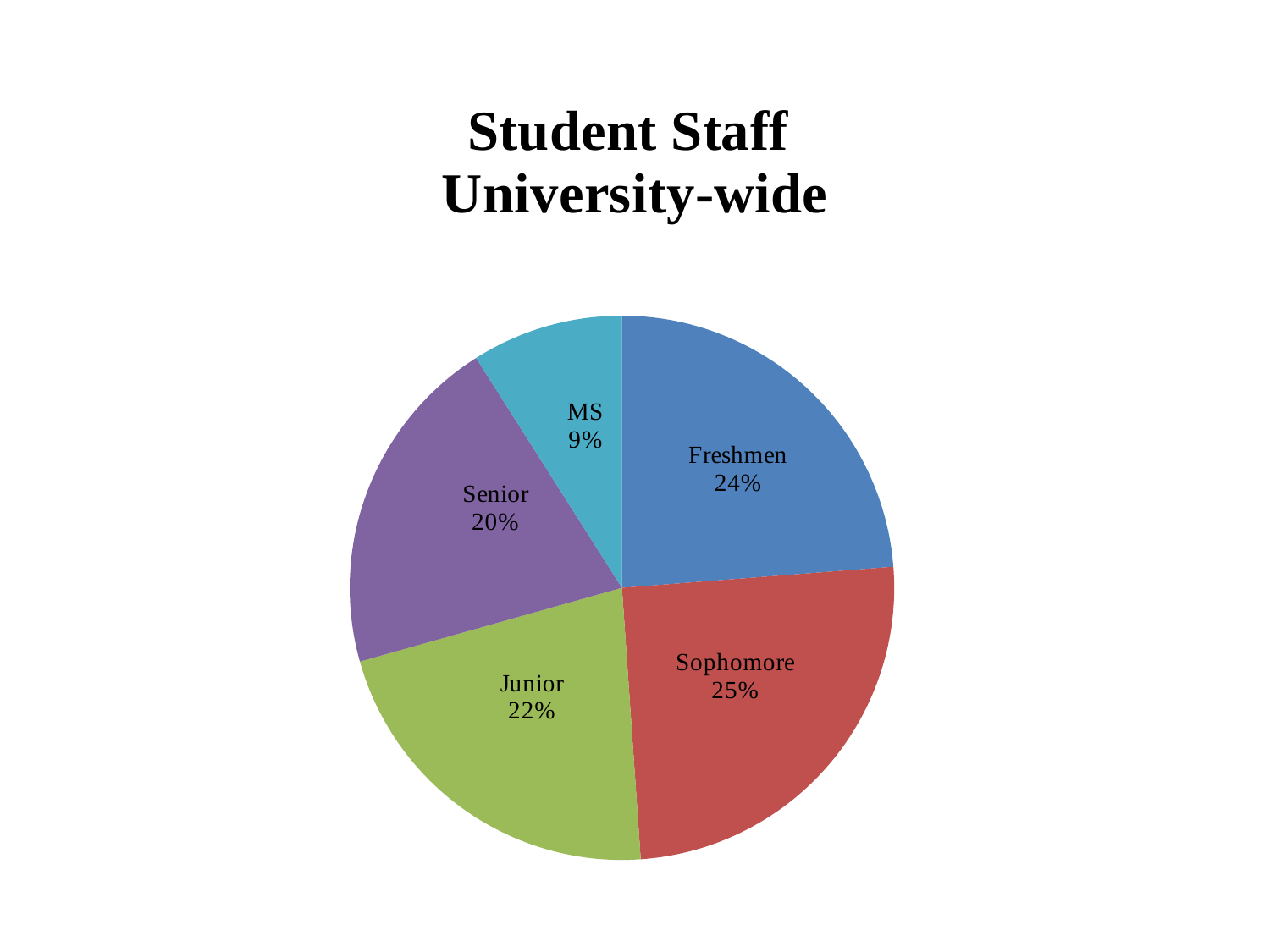
Which category has the smallest slice of the pie? MS Which category has the largest slice of the pie? Sophomore What share of the pie does the Sophomore slice represent? 25% What is the value shown for Freshmen? 24% What is the value shown for Senior? 20% What percentage is shown for the MS slice? 9% What is the difference in percentage points between the Freshmen and MS slices? 15 What is the difference in percentage points between the Junior and Senior slices? 2 Which is larger, the Junior slice or the Senior slice? Junior What kind of chart is shown on the slide? Pie chart What is the title of the chart? Student Staff University-wide How many categories are shown in the pie chart? 5